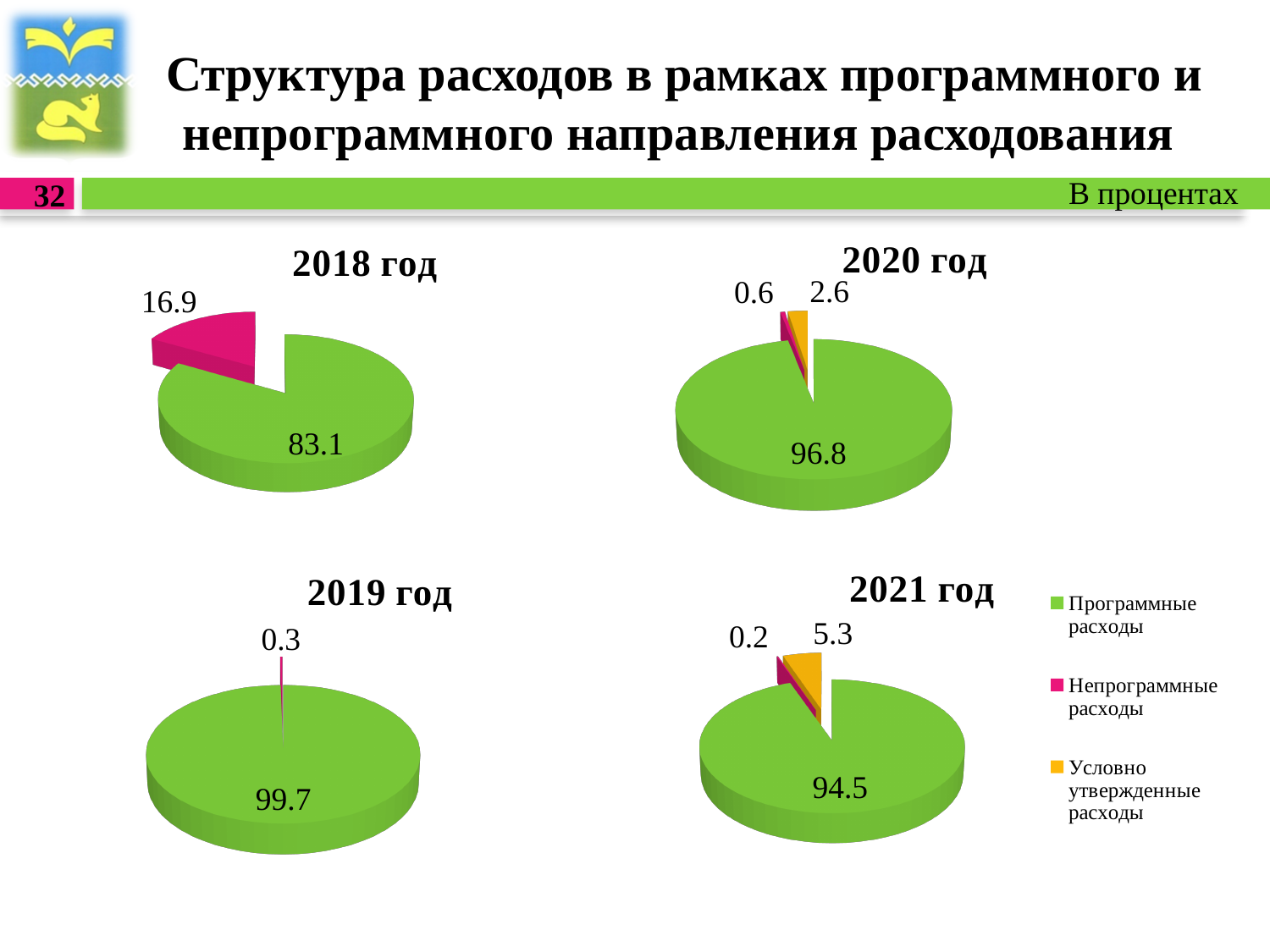
In the '2018 год' pie chart, what is the difference between Программные расходы and Непрограммные расходы? 66.2 In the '2021 год' pie chart, what is the value for Программные расходы? 94.5 In the '2020 год' pie chart, which category has the largest slice? Программные расходы How many entries does the legend list? 3 How many slices does the '2021 год' pie chart have? 3 In the '2018 год' pie chart, what is the value for Непрограммные расходы? 16.9 Which is larger: Условно утвержденные расходы in the '2020 год' chart or in the '2021 год' chart? 2021 год In the '2018 год' pie chart, what is the value for Программные расходы? 83.1 In the '2019 год' pie chart, what is the value for Непрограммные расходы? 0.3 In the '2021 год' pie chart, which category has the smallest slice? Непрограммные расходы What kind of chart is used for '2019 год'? Pie chart In the '2020 год' pie chart, what is the value for Условно утвержденные расходы? 2.6